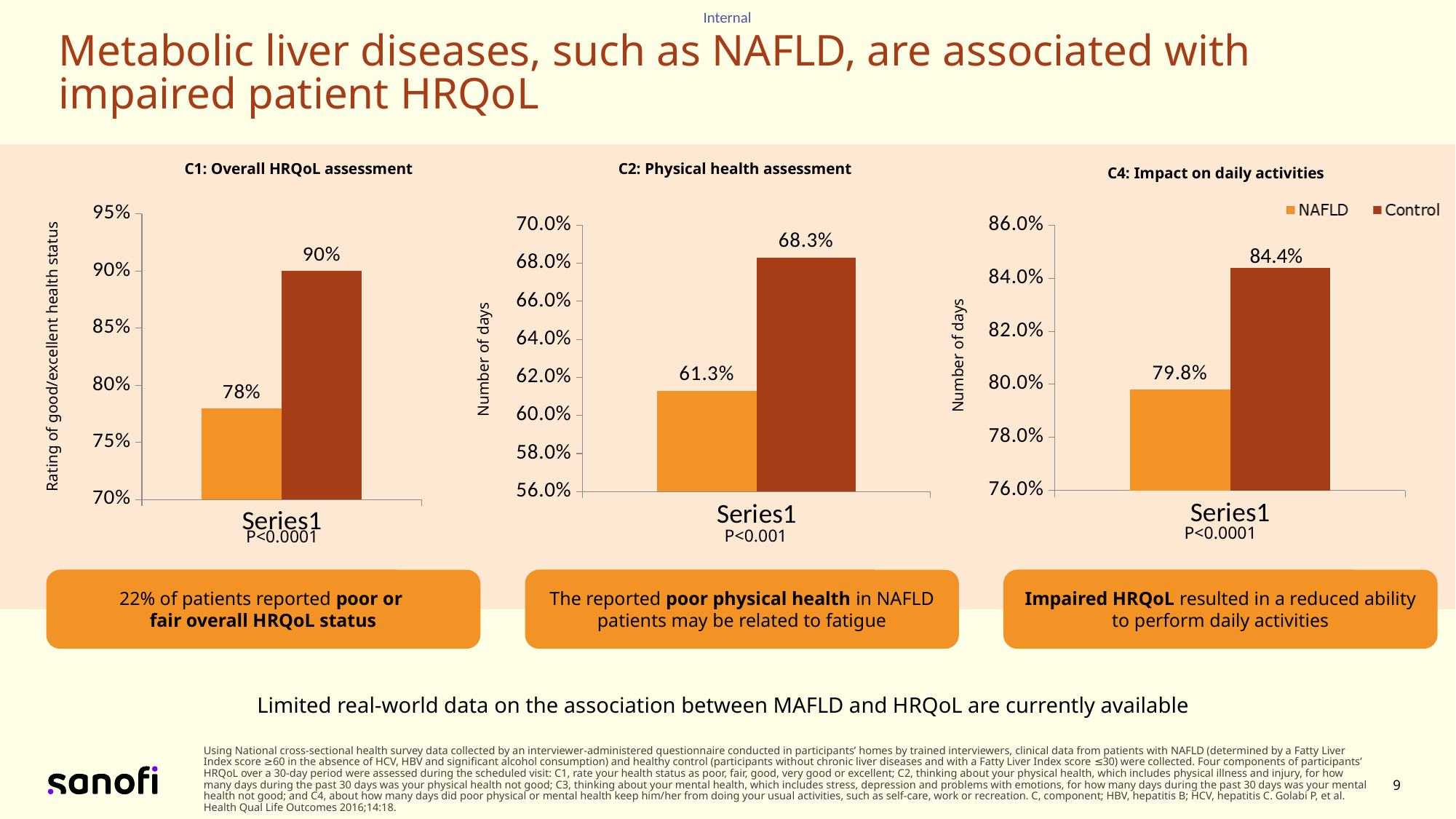
How many series does the legend on the 'C4: Impact on daily activities' chart list? 2 In the 'C1: Overall HRQoL assessment' chart, what is the difference between the Control and NAFLD values? 12% In the 'C2: Physical health assessment' chart, is the NAFLD value greater or less than 62.0%? less In the 'C2: Physical health assessment' chart, what value is shown for the NAFLD bar? 61.3% In the 'C1: Overall HRQoL assessment' chart, what value is shown for the Control bar? 90% In the 'C4: Impact on daily activities' chart, what value is shown for the Control bar? 84.4% What type of chart is 'C1: Overall HRQoL assessment'? Bar chart In the 'C2: Physical health assessment' chart, what value is shown for the Control bar? 68.3% In the 'C2: Physical health assessment' chart, what is the difference between the Control and NAFLD values? 7.0% In the 'C1: Overall HRQoL assessment' chart, what value is shown for the NAFLD bar? 78% In the 'C4: Impact on daily activities' chart, which bar is higher, NAFLD or Control? Control In the 'C4: Impact on daily activities' chart, what value is shown for the NAFLD bar? 79.8%